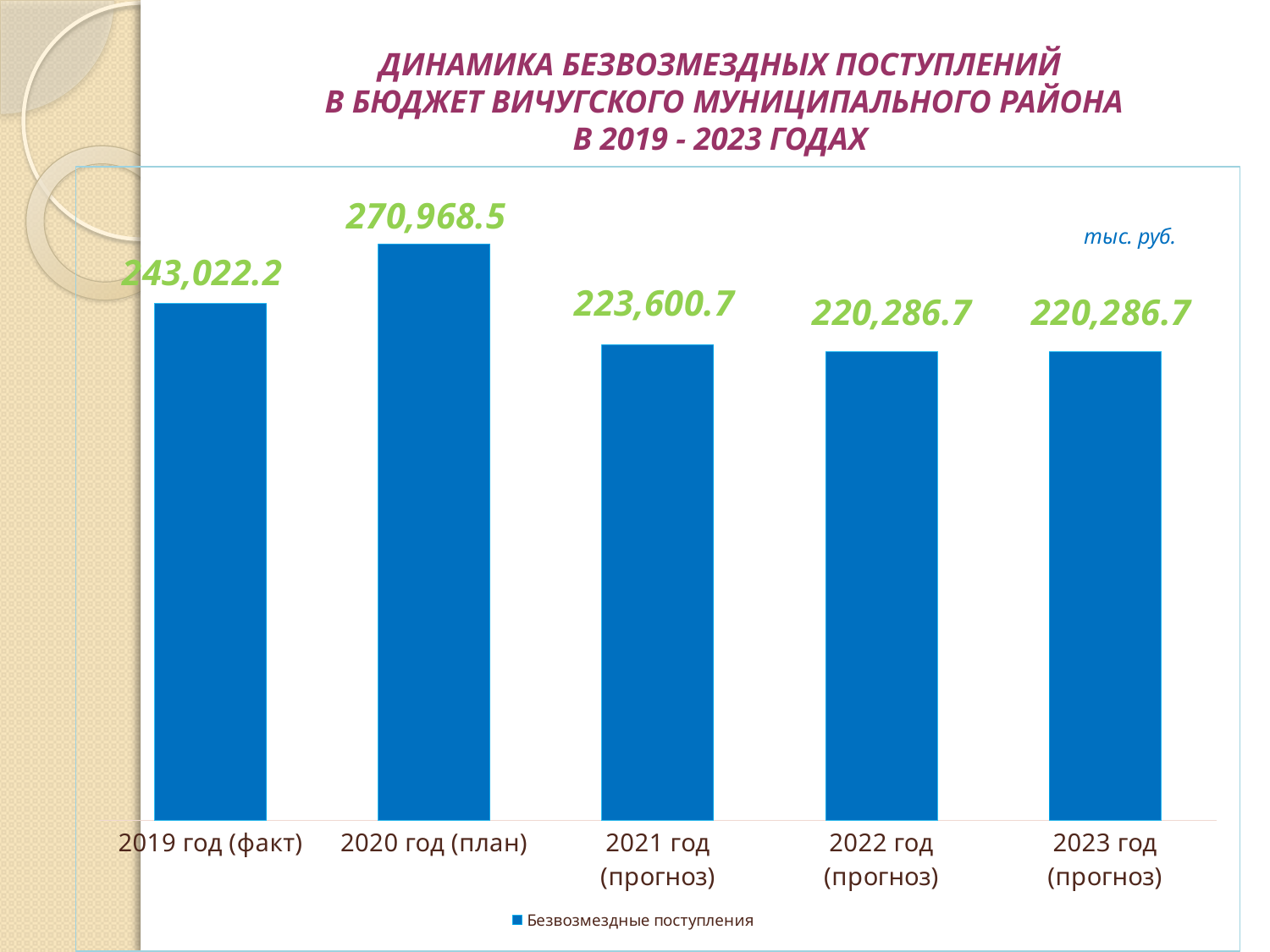
What kind of chart is shown on the slide? bar chart Which is larger, the value for 2019 год (факт) or the value for 2021 год (прогноз)? 2019 год (факт) What is the value for 2020 год (план)? 270,968.5 What is the value for 2019 год (факт)? 243,022.2 How many bars are shown in the chart? 5 How many series does the legend list? 1 What is the difference between the values for 2021 год (прогноз) and 2022 год (прогноз)? 3,314.0 What is the value for 2023 год (прогноз)? 220,286.7 What unit is indicated on the chart? тыс. руб. What is the value for 2021 год (прогноз)? 223,600.7 Which year has the highest value? 2020 год (план) What is the difference between the values for 2020 год (план) and 2019 год (факт)? 27,946.3